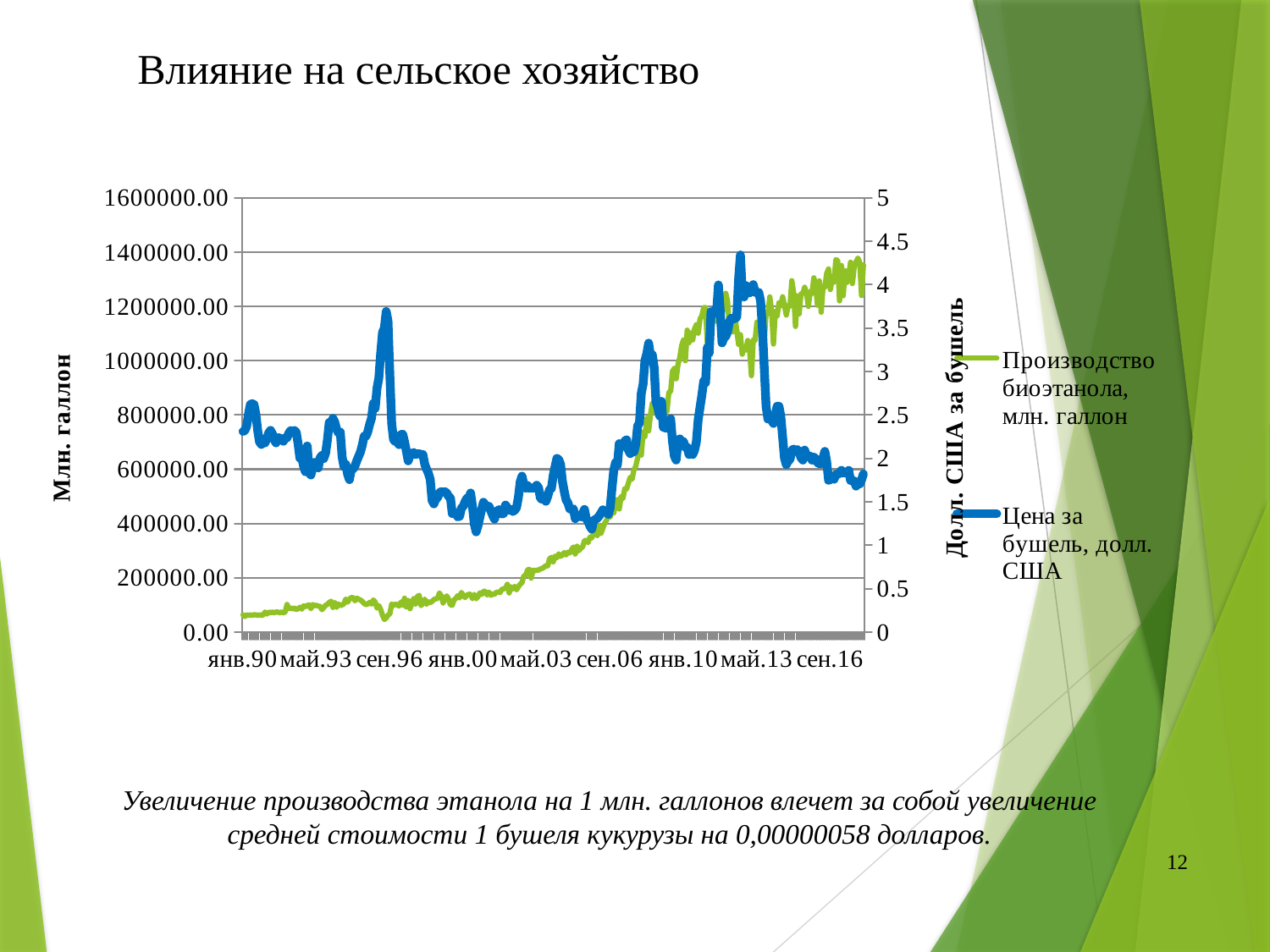
Is the value of Производство биоэтанола at янв.90 greater or less than 200000.00 on the left axis? less Is the value of Цена за бушель at сен.16 greater or less than 2 on the right axis? less Is the value of Цена за бушель at янв.90 greater or less than 2 on the right axis? greater Which series is drawn in green? Производство биоэтанола, млн. галлон How many series does the chart legend list? 2 What is the first date label on the x axis? янв.90 How many date labels are printed along the x axis? 9 What kind of chart is shown on the slide? line chart What is the title of the left vertical axis? Млн. галлон Does the bioethanol production (Производство биоэтанола) series rise or fall overall from янв.90 to сен.16? rise